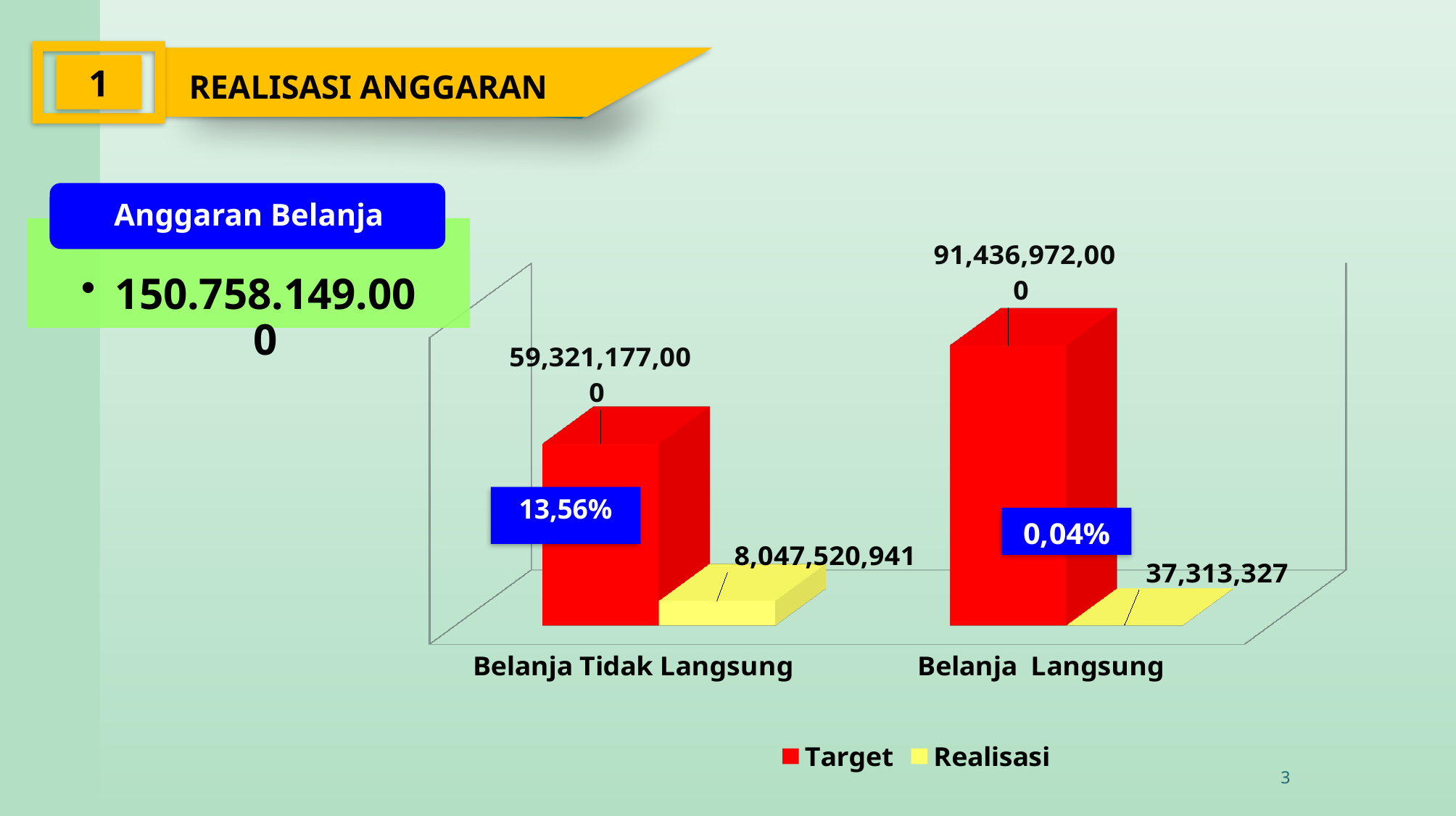
How many categories are shown on the x axis of the chart? 2 What is the Target value for Belanja Tidak Langsung? 59,321,177,000 What is the Realisasi value for Belanja Tidak Langsung? 8,047,520,941 How many series does the chart legend list? 2 What percentage label is shown on the Belanja Tidak Langsung bar? 13,56% Which category has the lower Realisasi value? Belanja Langsung What is the difference between the Target values for Belanja Langsung and Belanja Tidak Langsung? 32,115,795,000 What is the Realisasi value for Belanja Langsung? 37,313,327 Which category has the higher Target value? Belanja Langsung What is the Target value for Belanja Langsung? 91,436,972,000 Is the Realisasi value for Belanja Tidak Langsung larger or smaller than the Realisasi value for Belanja Langsung? larger What type of chart is shown on the slide? bar chart